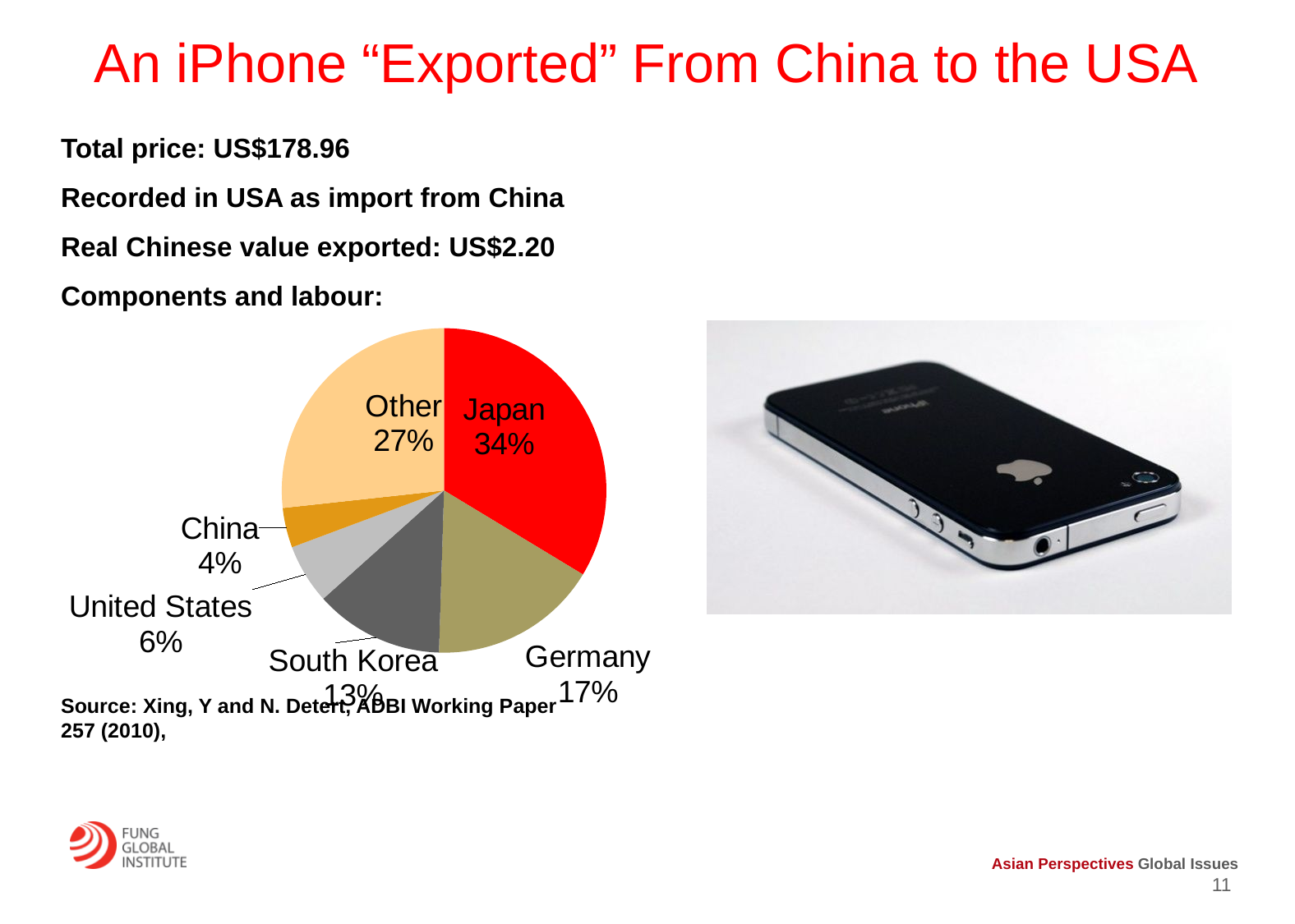
What share of the pie does Japan account for? 34% Which category has the smallest slice of the pie? China How many slices does the pie chart have? 6 Which is larger, the share for Other or the share for Germany? Other What share of the pie does the United States account for? 6% What kind of chart is shown on the slide? pie chart What is the difference in percentage points between Japan's share and Germany's share? 17 What share of the pie does Germany account for? 17% What share of the pie does South Korea account for? 13% Which category has the largest slice of the pie? Japan What colour is the Japan slice of the pie? red What share of the pie does China account for? 4%